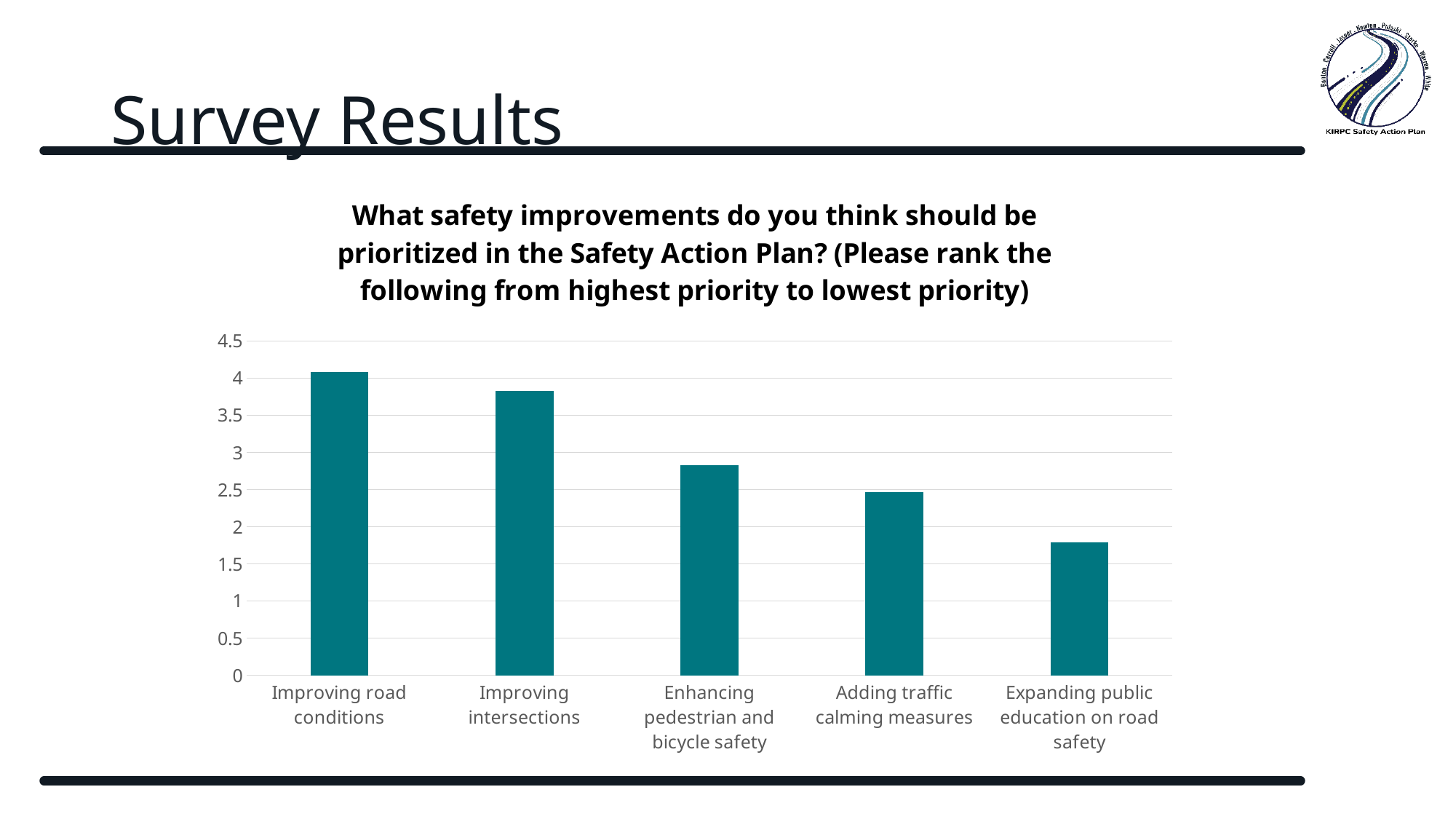
Is the value for Adding traffic calming measures greater or less than 2? greater Which category has the highest value in the chart? Improving road conditions What is the highest tick value shown on the vertical axis of the chart? 4.5 Which is larger: the value for Enhancing pedestrian and bicycle safety or the value for Expanding public education on road safety? Enhancing pedestrian and bicycle safety Is the value for Enhancing pedestrian and bicycle safety greater or less than 3? less Which category has the lowest value in the chart? Expanding public education on road safety Is the value for Improving road conditions greater or less than 3.5? greater How many categories are shown on the x axis of the chart? 5 Which is larger: the value for Improving road conditions or the value for Improving intersections? Improving road conditions What kind of chart is shown on the slide? bar chart Do the values rise or fall moving from left to right along the x axis? fall